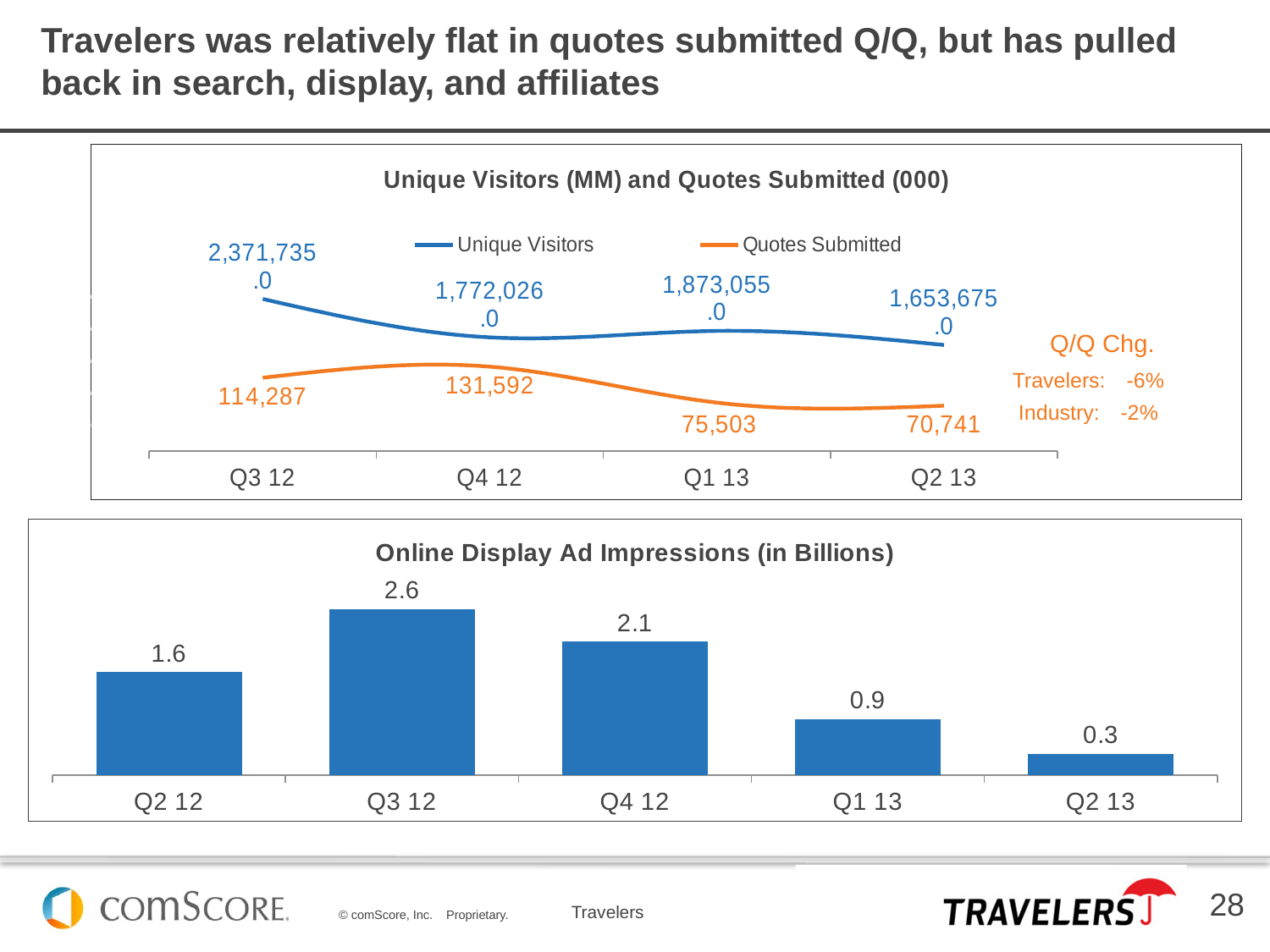
In the 'Unique Visitors (MM) and Quotes Submitted (000)' chart, which quarter has the highest Quotes Submitted value? Q4 12 In the 'Online Display Ad Impressions (in Billions)' chart, which quarter has the lowest value? Q2 13 In the 'Unique Visitors (MM) and Quotes Submitted (000)' chart, how many series does the legend list? 2 In the 'Unique Visitors (MM) and Quotes Submitted (000)' chart, what is the Unique Visitors value for Q2 13? 1,653,675.0 In the 'Online Display Ad Impressions (in Billions)' chart, do the values rise or fall from Q3 12 to Q2 13? Fall In the 'Online Display Ad Impressions (in Billions)' chart, what is the difference between the Q4 12 and Q1 13 values? 1.2 In the 'Online Display Ad Impressions (in Billions)' chart, which quarter has the highest value? Q3 12 In the 'Online Display Ad Impressions (in Billions)' chart, what is the value for Q3 12? 2.6 What kind of chart is the 'Online Display Ad Impressions (in Billions)' chart? Bar chart In the 'Unique Visitors (MM) and Quotes Submitted (000)' chart, is the Unique Visitors value larger in Q3 12 or Q4 12? Q3 12 In the 'Online Display Ad Impressions (in Billions)' chart, how many quarters are shown? 5 In the 'Unique Visitors (MM) and Quotes Submitted (000)' chart, what is the Quotes Submitted value for Q4 12? 131,592